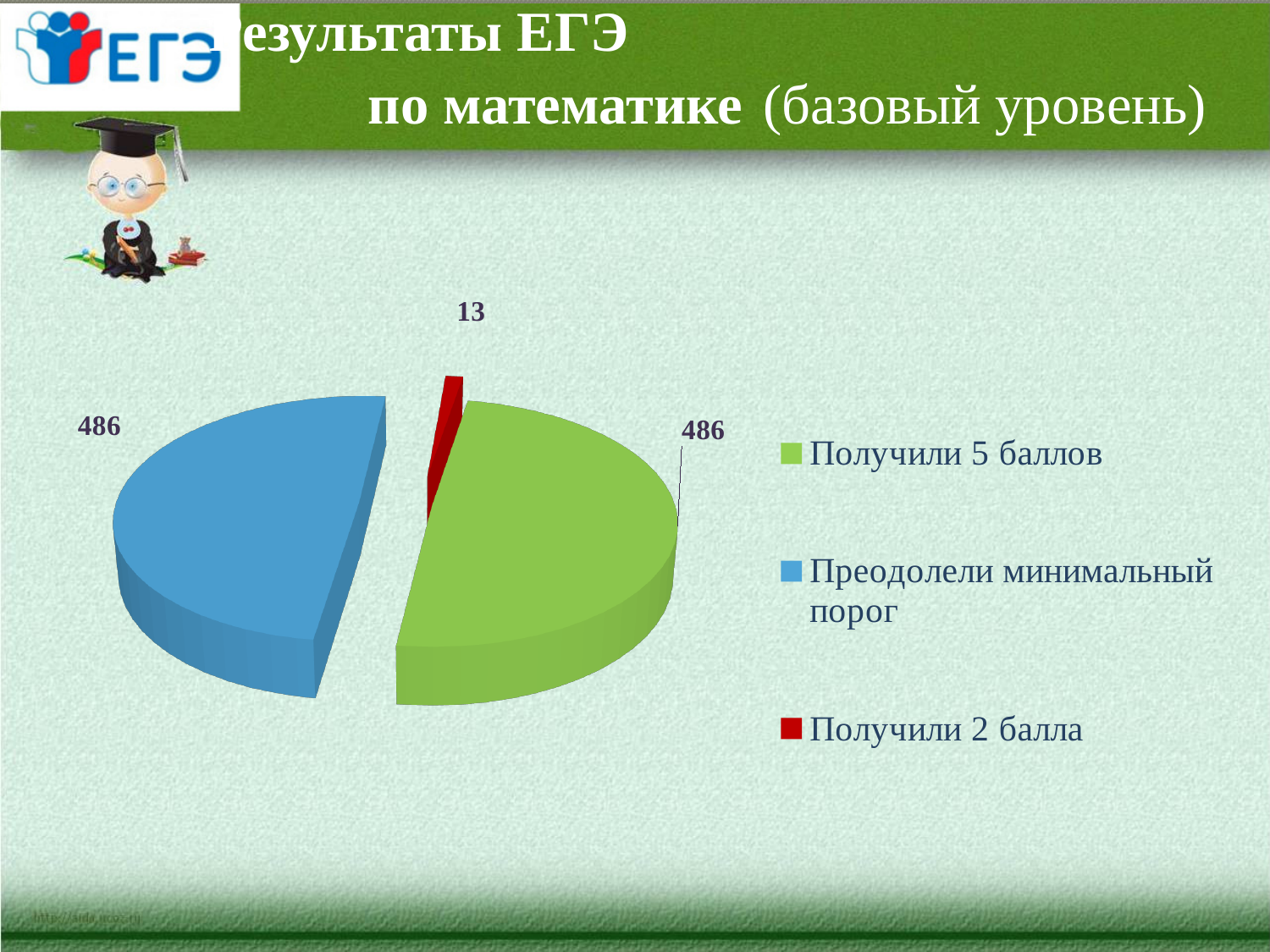
What is the difference between the values for "Получили 5 баллов" and "Получили 2 балла"? 473 Which is larger: "Получили 5 баллов" or "Получили 2 балла"? Получили 5 баллов How many slices does the pie chart have? 3 What is the total of all the values shown in the pie chart? 985 How many entries does the legend list? 3 What is the value for "Получили 5 баллов"? 486 What is the value for "Получили 2 балла"? 13 What is the difference between the values for "Получили 5 баллов" and "Преодолели минимальный порог"? 0 Which colour represents "Получили 2 балла" in the legend? red What is the value for "Преодолели минимальный порог"? 486 Which category has the smallest slice of the pie? Получили 2 балла What kind of chart is shown on the slide? pie chart